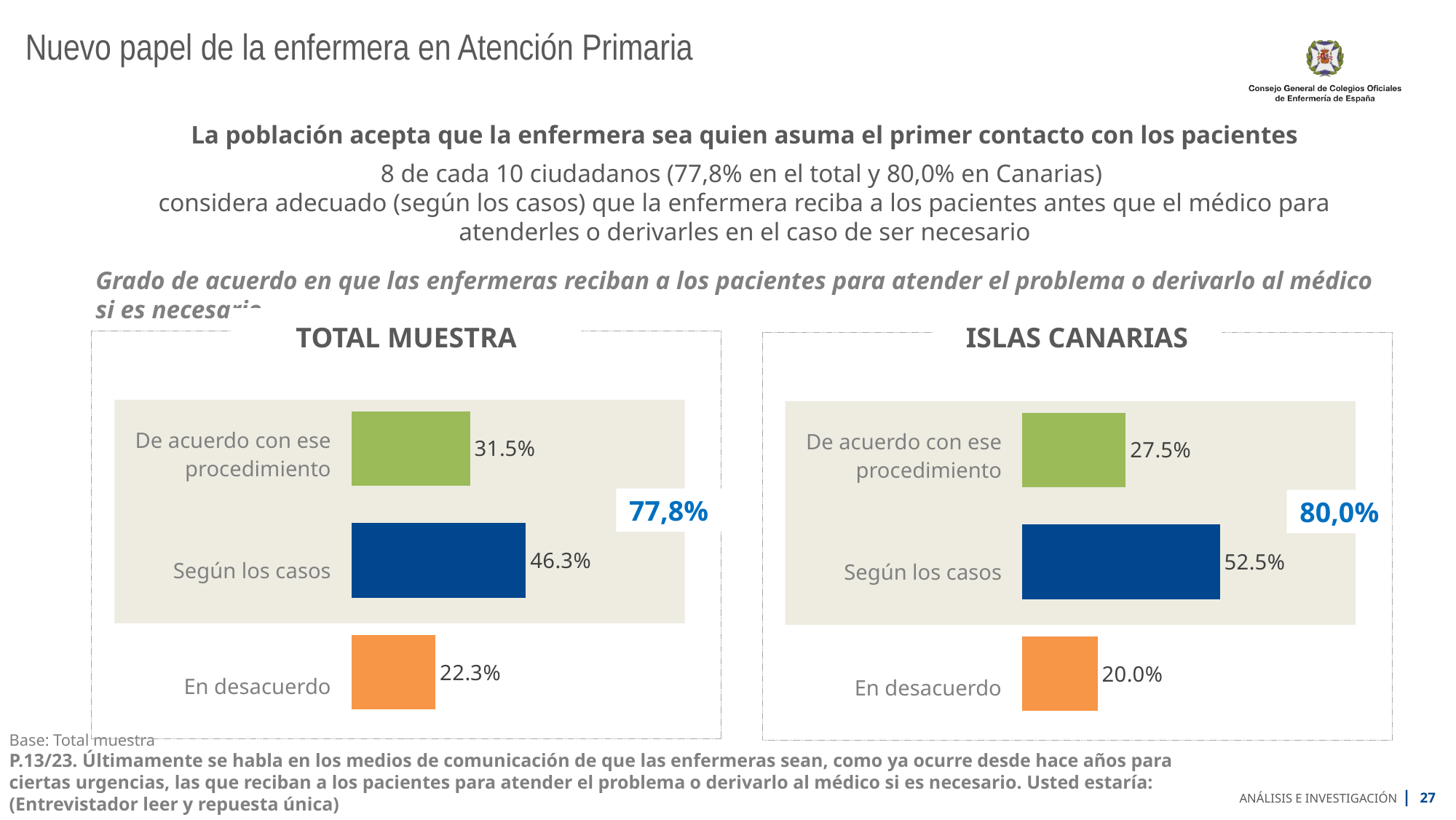
In the TOTAL MUESTRA chart, what is the value for "Según los casos"? 46.3% What kind of chart is the TOTAL MUESTRA chart? Bar chart How many categories does the ISLAS CANARIAS chart show? 3 In the ISLAS CANARIAS chart, what is the value for "En desacuerdo"? 20.0% In the TOTAL MUESTRA chart, what colour is the bar for "En desacuerdo"? Orange In the TOTAL MUESTRA chart, which category has the lowest value? En desacuerdo In the ISLAS CANARIAS chart, which category has the highest value? Según los casos Which is larger: "De acuerdo con ese procedimiento" in the TOTAL MUESTRA chart or in the ISLAS CANARIAS chart? TOTAL MUESTRA In the ISLAS CANARIAS chart, what combined percentage is highlighted in blue next to the first two bars? 80,0% In the TOTAL MUESTRA chart, what is the value for "De acuerdo con ese procedimiento"? 31.5% In the TOTAL MUESTRA chart, what is the difference between "Según los casos" and "En desacuerdo"? 24.0% In the ISLAS CANARIAS chart, what is the difference between "Según los casos" and "De acuerdo con ese procedimiento"? 25.0%